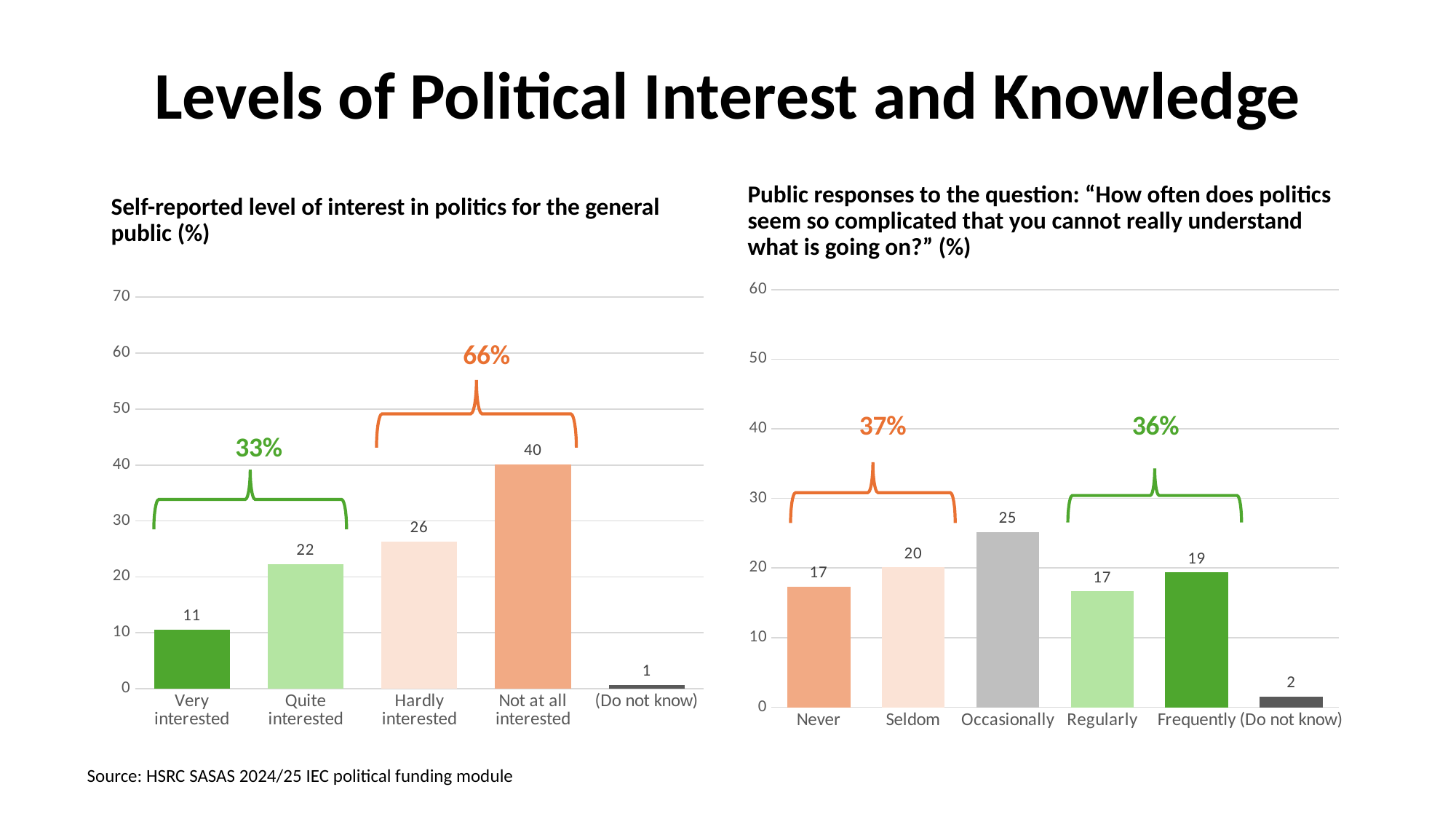
In the right chart (how often politics seems too complicated), what is the difference between 'Occasionally' and 'Never'? 8 In the right chart (how often politics seems too complicated), which is larger, 'Seldom' or 'Frequently'? Seldom In the left chart (self-reported level of interest in politics), which category has the lowest value? (Do not know) In the right chart (how often politics seems too complicated), which category has the highest value? Occasionally What type of chart is the right chart (how often politics seems too complicated)? Bar chart In the right chart (how often politics seems too complicated), what combined percentage is shown by the orange bracket over 'Never' and 'Seldom'? 37% In the left chart (self-reported level of interest in politics), which category has the highest value? Not at all interested In the right chart (how often politics seems too complicated), what is the value for 'Occasionally'? 25 In the left chart (self-reported level of interest in politics), what is the difference between 'Not at all interested' and 'Hardly interested'? 14 In the left chart (self-reported level of interest in politics), how many categories are shown on the x axis? 5 In the left chart (self-reported level of interest in politics), what combined percentage is shown by the green bracket over 'Very interested' and 'Quite interested'? 33% In the left chart (self-reported level of interest in politics), what is the value for 'Quite interested'? 22